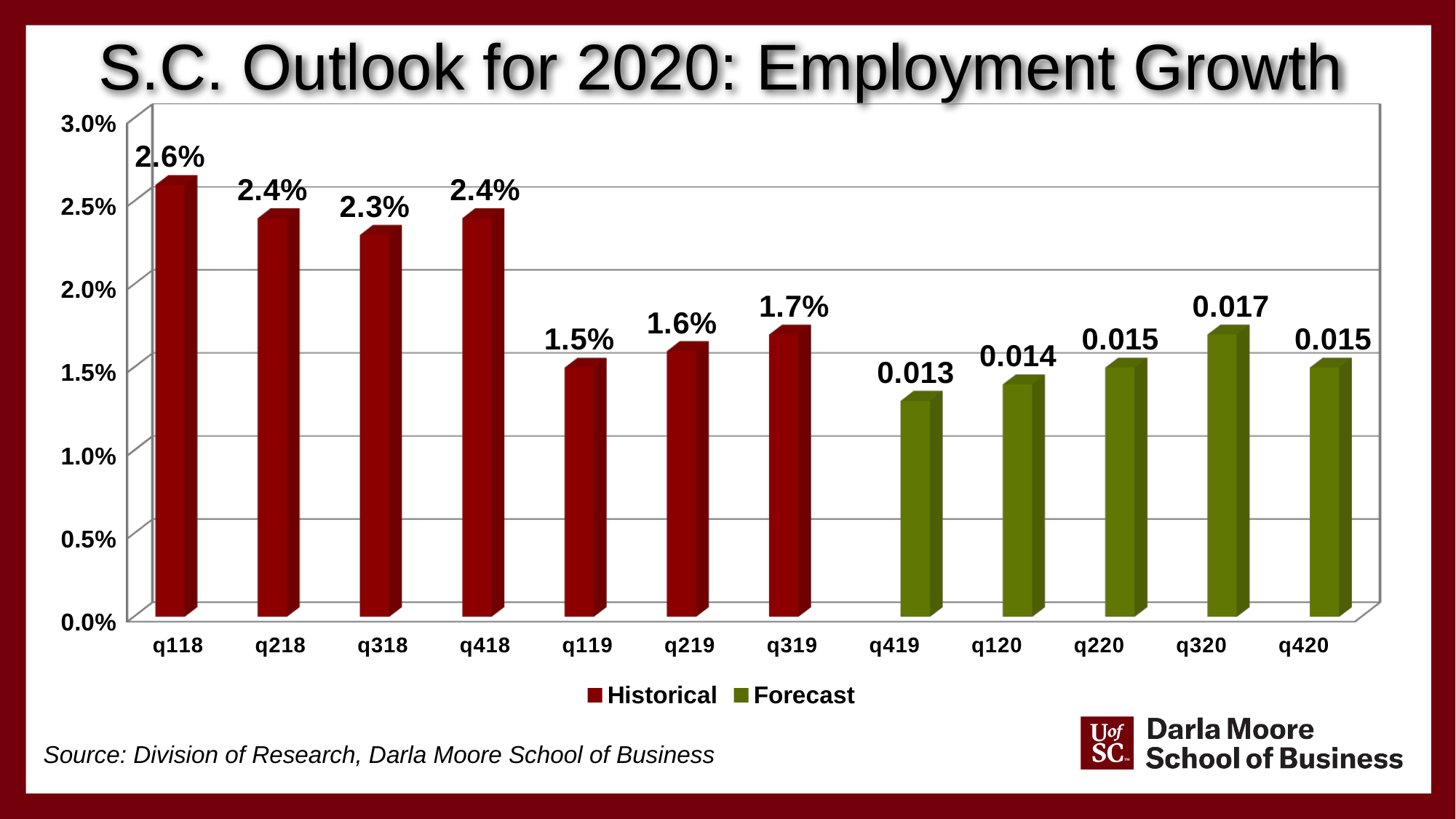
What kind of chart is shown on the slide? bar chart Which quarter has the highest employment growth on the chart? q118 Do the values rise or fall from q419 to q320? rise What is the employment growth value shown for q118? 2.6% Is the value for q419 greater or less than 1.5%? less How many quarters are plotted on the chart? 12 How many series does the legend list? 2 Which is larger, the value for q320 or the value for q420? q320 What is the value shown for q119? 1.5% What value is labelled on the q320 bar? 0.017 Which quarter has the lowest bar on the chart? q419 What is the difference between the values for q118 and q318? 0.3%